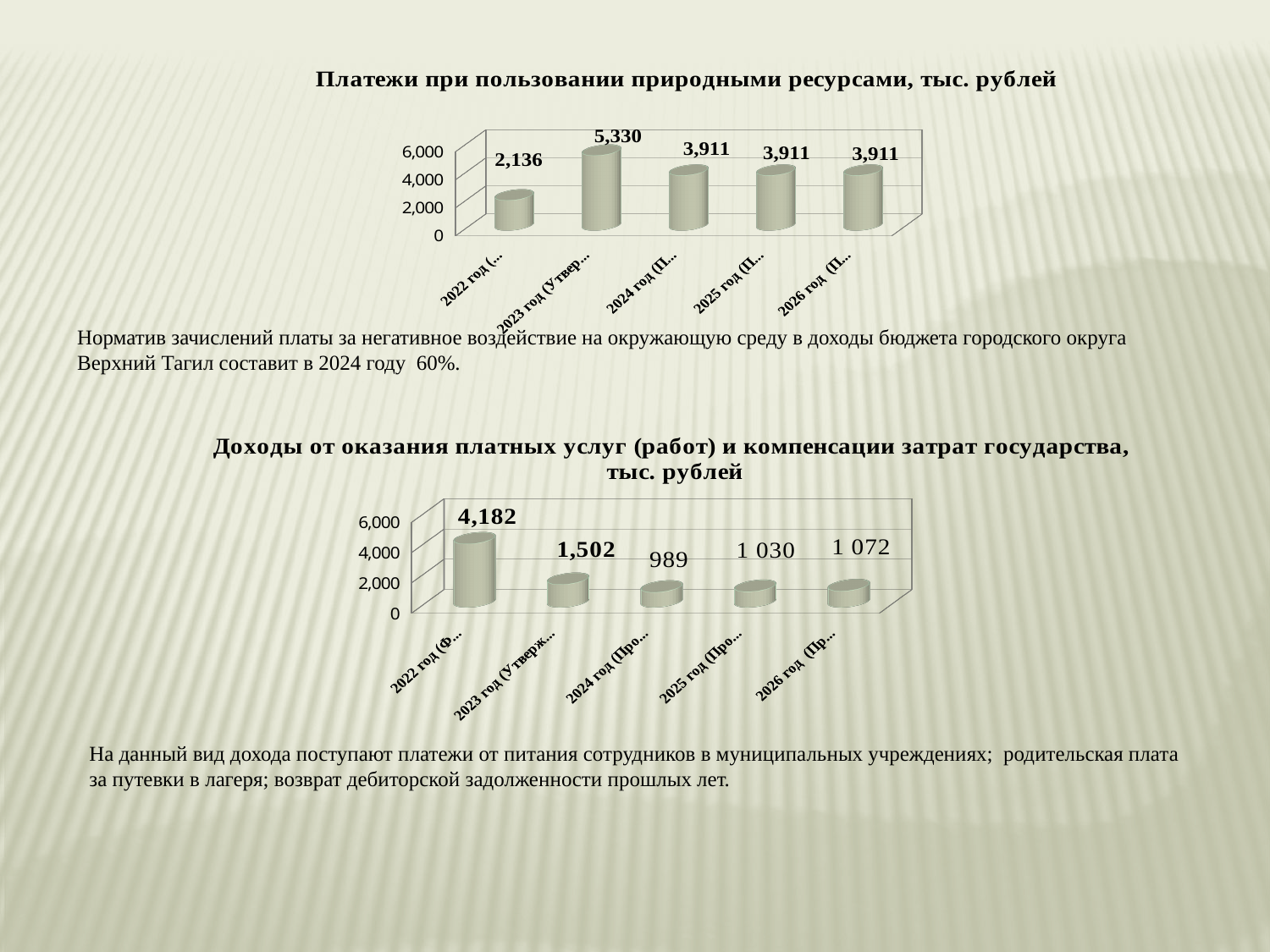
In the chart 'Платежи при пользовании природными ресурсами, тыс. рублей', what is the difference between the values for 2023 год and 2022 год? 3,194 In the chart 'Платежи при пользовании природными ресурсами, тыс. рублей', which year has the lowest value? 2022 год In the chart 'Платежи при пользовании природными ресурсами, тыс. рублей', what is the value for 2023 год? 5,330 In the chart 'Доходы от оказания платных услуг (работ) и компенсации затрат государства, тыс. рублей', what is the difference between the values for 2022 год and 2023 год? 2,680 In the chart 'Платежи при пользовании природными ресурсами, тыс. рублей', how many bars are plotted? 5 In the chart 'Доходы от оказания платных услуг (работ) и компенсации затрат государства, тыс. рублей', what is the value for 2022 год? 4,182 In the chart 'Доходы от оказания платных услуг (работ) и компенсации затрат государства, тыс. рублей', which is larger, the value for 2022 год or 2023 год? 2022 год What kind of chart is the bottom chart on the slide? Bar chart In the chart 'Доходы от оказания платных услуг (работ) и компенсации затрат государства, тыс. рублей', which year has the lowest value? 2024 год In the chart 'Платежи при пользовании природными ресурсами, тыс. рублей', what is the value for 2022 год? 2,136 In the chart 'Платежи при пользовании природными ресурсами, тыс. рублей', which year has the highest value? 2023 год In the chart 'Доходы от оказания платных услуг (работ) и компенсации затрат государства, тыс. рублей', what is the value for 2024 год? 989